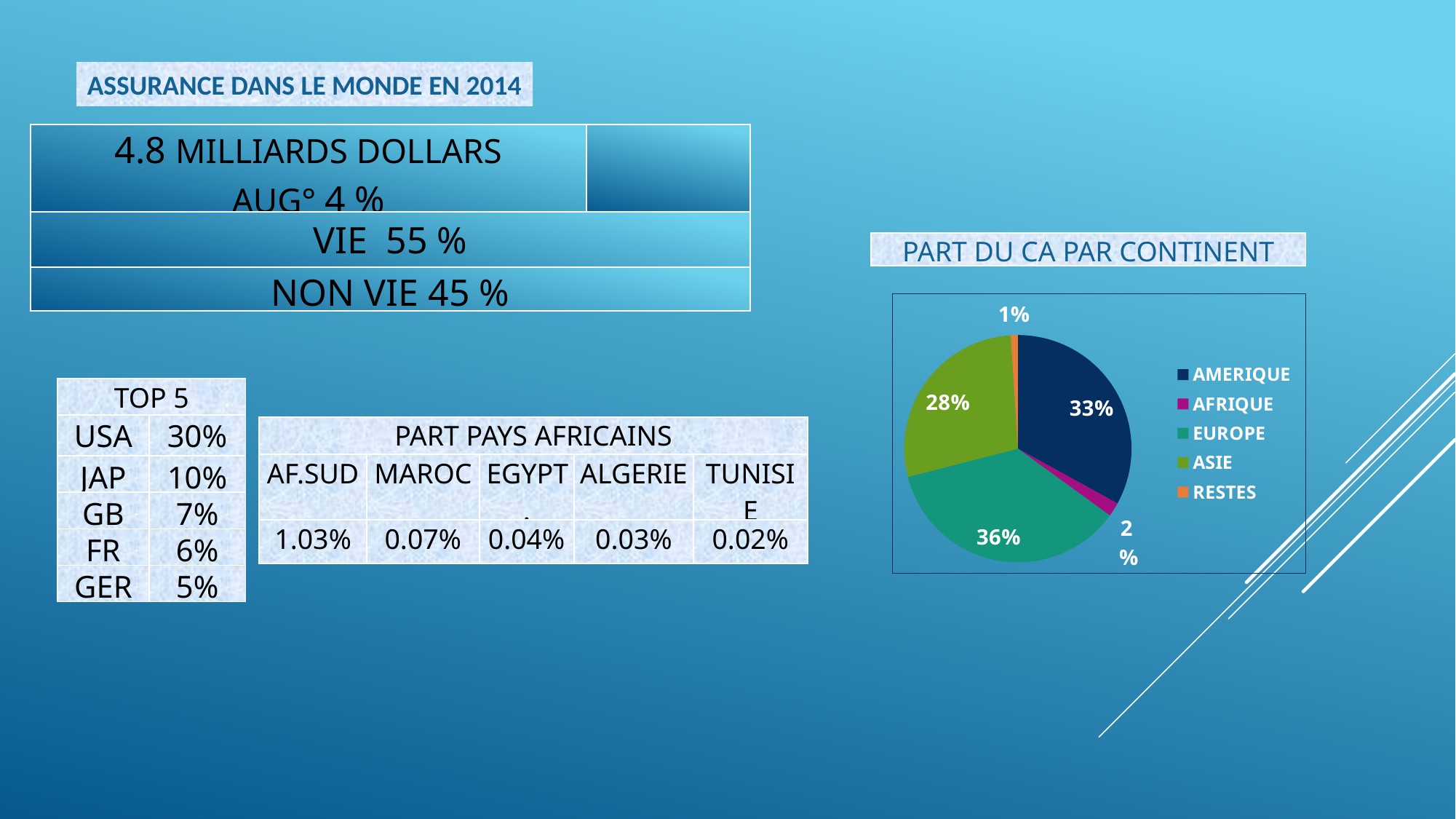
In the pie chart, what share is shown for AMERIQUE? 33% Which continent has the largest slice in the pie chart? EUROPE What is the title of the pie chart? PART DU CA PAR CONTINENT In the pie chart, what share is shown for EUROPE? 36% How many slices does the pie chart have? 5 What kind of chart is shown on the slide? Pie chart In the pie chart, what share is shown for RESTES? 1% In the pie chart, what is the difference between the shares of EUROPE and AMERIQUE? 3% Which category has the smallest slice in the pie chart? RESTES In the pie chart, what share is shown for ASIE? 28% In the pie chart, what share is shown for AFRIQUE? 2% In the pie chart, which has the larger share, AMERIQUE or ASIE? AMERIQUE